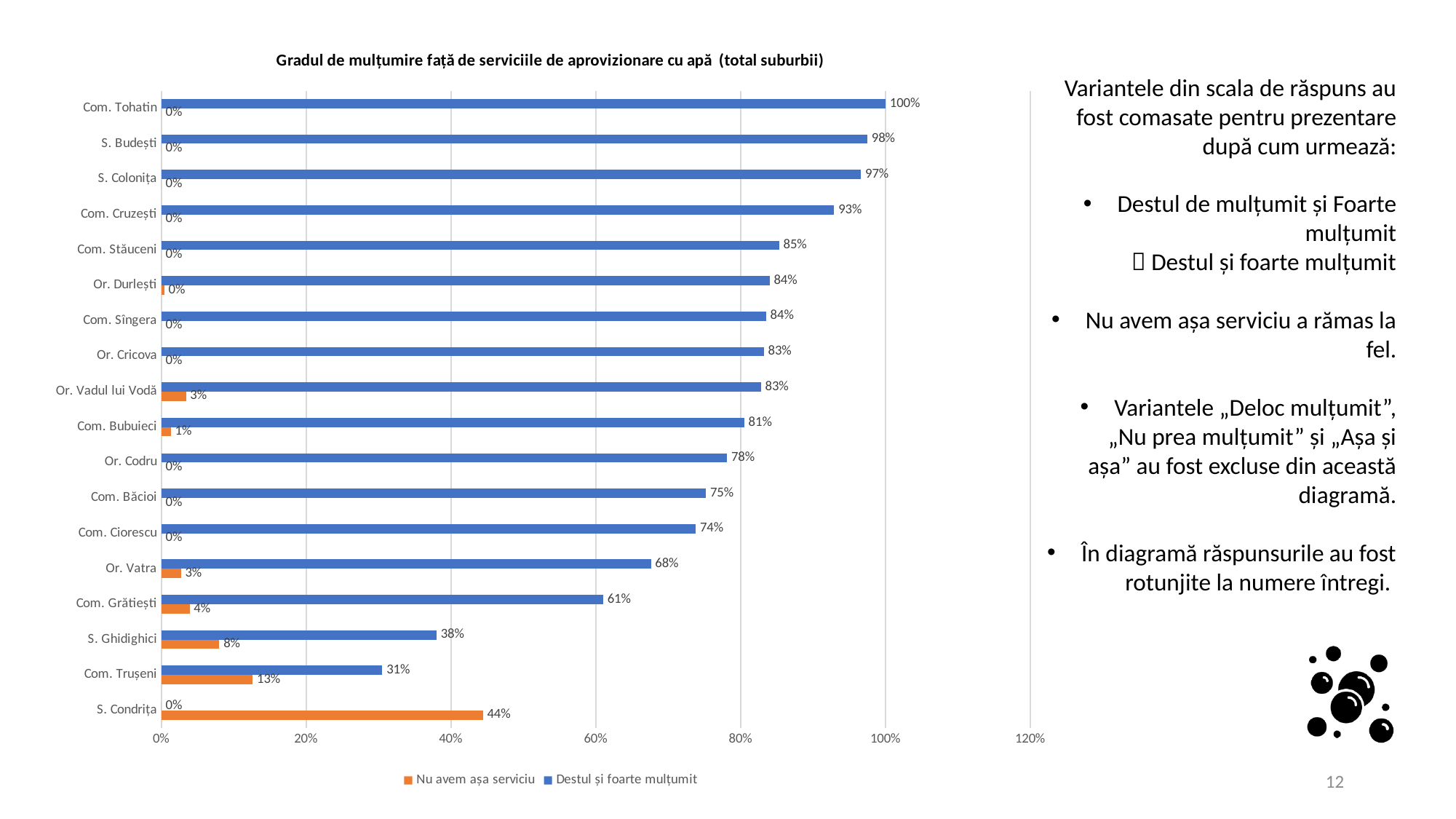
Which category has the highest value for "Nu avem așa serviciu"? S. Condrița How many series does the legend list? 2 What is the value of "Destul și foarte mulțumit" for Com. Tohatin? 100% What is the value of "Nu avem așa serviciu" for S. Condrița? 44% What is the value of "Destul și foarte mulțumit" for Com. Trușeni? 31% Which category has the lowest value for "Destul și foarte mulțumit"? S. Condrița How many categories (localities) are shown on the chart? 18 What type of chart is shown on the slide? Bar chart What is the value of "Nu avem așa serviciu" for S. Ghidighici? 8% Which has a larger "Destul și foarte mulțumit" value, Or. Vatra or Com. Ciorescu? Com. Ciorescu Which category has the highest value for "Destul și foarte mulțumit"? Com. Tohatin What is the difference between the "Destul și foarte mulțumit" values for S. Budești and Com. Grătiești? 37%